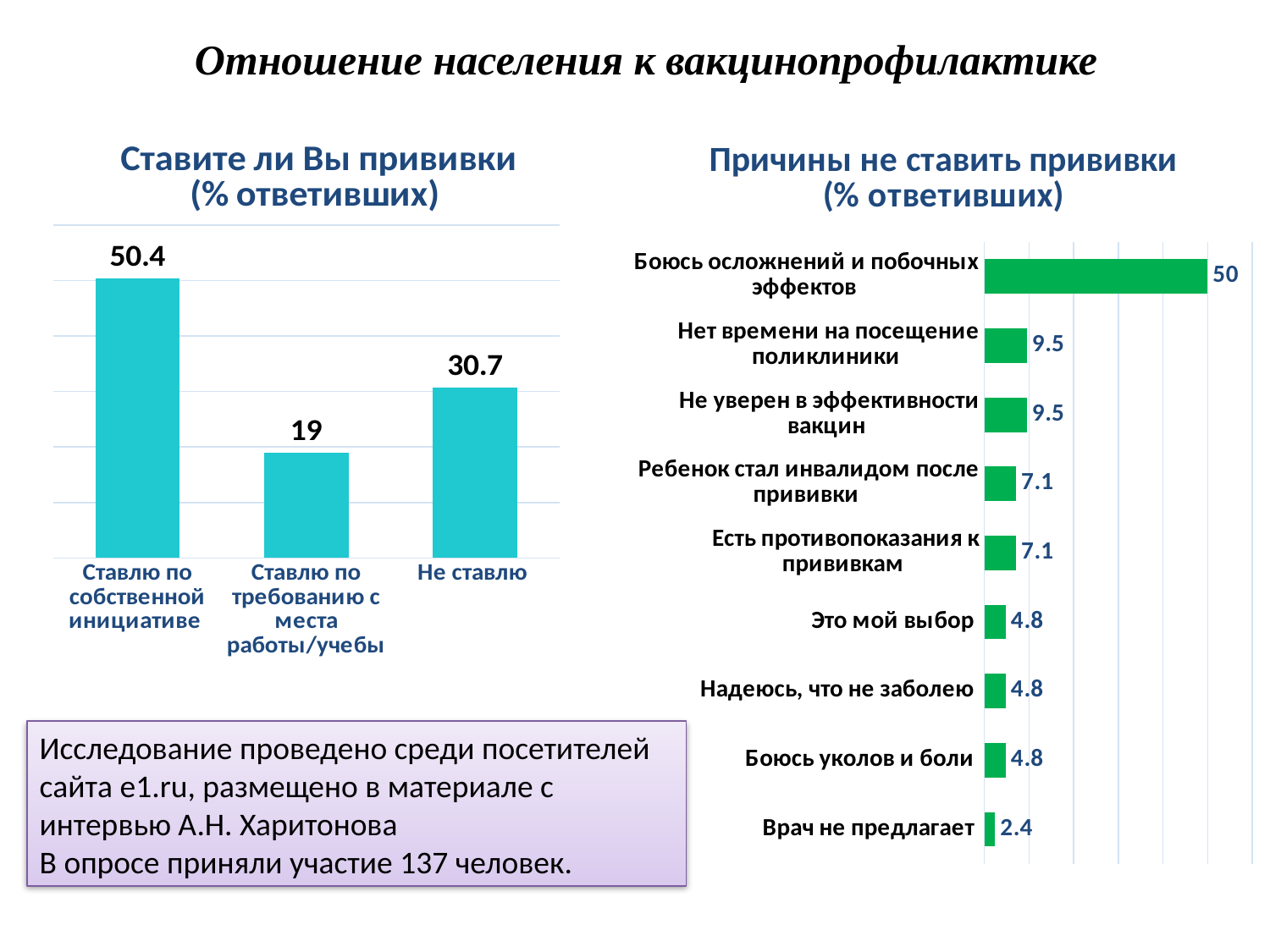
In the chart 'Ставите ли Вы прививки (% ответивших)', what is the difference between 'Ставлю по собственной инициативе' and 'Не ставлю'? 19.7 In the chart 'Причины не ставить прививки (% ответивших)', what is the value for 'Боюсь осложнений и побочных эффектов'? 50 In the chart 'Причины не ставить прививки (% ответивших)', which reason has the lowest value? Врач не предлагает In the chart 'Ставите ли Вы прививки (% ответивших)', what is the value for 'Ставлю по собственной инициативе'? 50.4 In the chart 'Причины не ставить прививки (% ответивших)', what is the difference between 'Боюсь осложнений и побочных эффектов' and 'Не уверен в эффективности вакцин'? 40.5 In the chart 'Причины не ставить прививки (% ответивших)', what is the value for 'Ребенок стал инвалидом после прививки'? 7.1 In the chart 'Ставите ли Вы прививки (% ответивших)', what kind of chart is it? bar chart In the chart 'Причины не ставить прививки (% ответивших)', which is larger: 'Нет времени на посещение поликлиники' or 'Это мой выбор'? Нет времени на посещение поликлиники In the chart 'Ставите ли Вы прививки (% ответивших)', how many categories are shown? 3 In the chart 'Причины не ставить прививки (% ответивших)', how many reasons are listed? 9 In the chart 'Причины не ставить прививки (% ответивших)', what colour are the bars? green In the chart 'Ставите ли Вы прививки (% ответивших)', which category has the lowest value? Ставлю по требованию с места работы/учебы